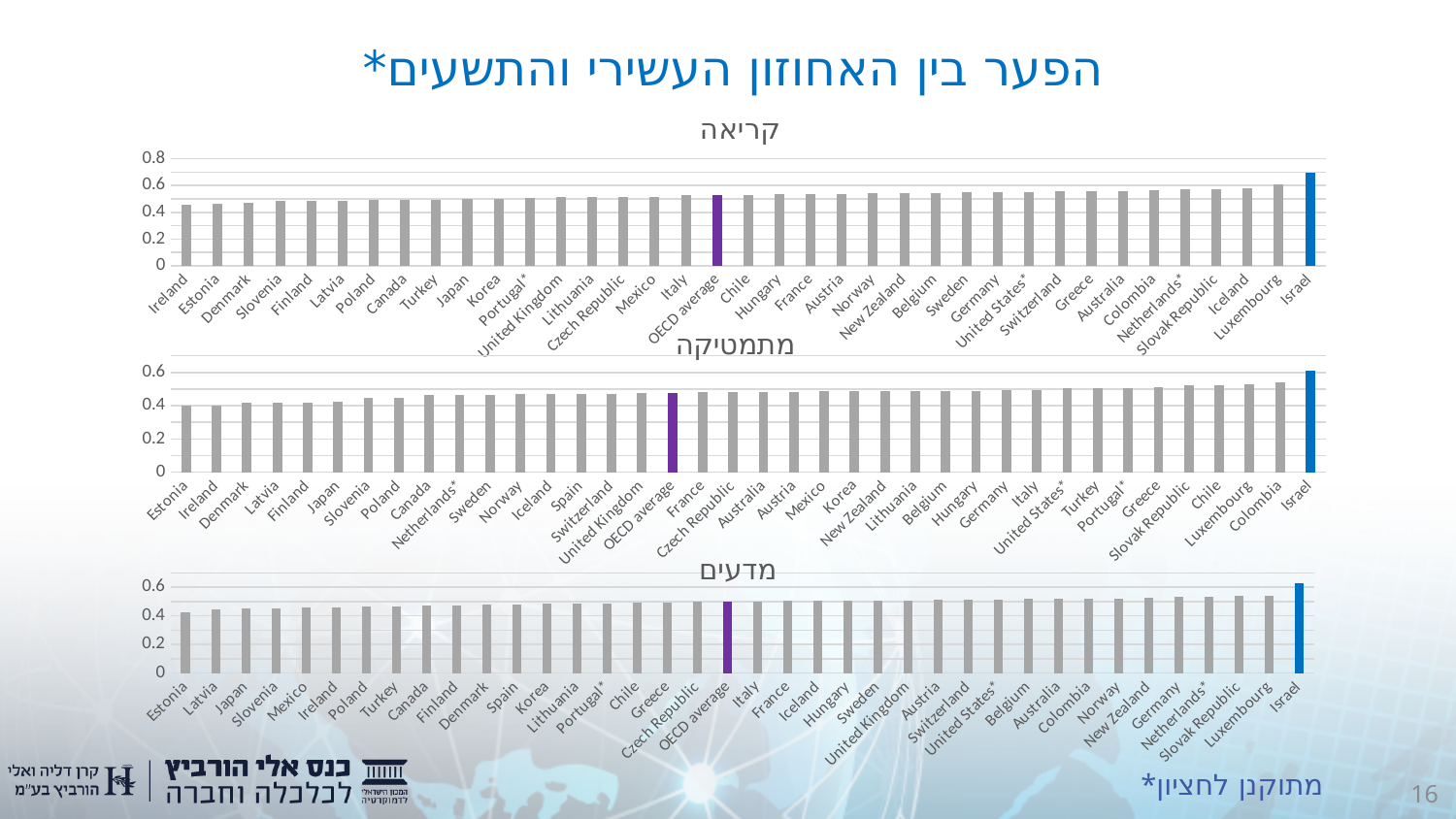
In the middle chart (מתמטיקה), which category is drawn as the purple bar? OECD average In the top chart (קריאה), which country has the highest value? Israel In the middle chart (מתמטיקה), which country has the lowest value? Estonia In the top chart (קריאה), is the value for Israel greater or less than 0.6? greater In the top chart (קריאה), which is larger, the value for Israel or the value for Ireland? Israel In the top chart (קריאה), is the value for Ireland greater or less than 0.6? less In the middle chart (מתמטיקה), is the value for Israel greater or less than 0.4? greater What kind of chart is the top chart titled קריאה? bar chart In the top chart (קריאה), which country has the lowest value? Ireland In the bottom chart (מדעים), do the values rise or fall from left to right along the x axis? rise In the bottom chart (מדעים), which country has the highest value? Israel